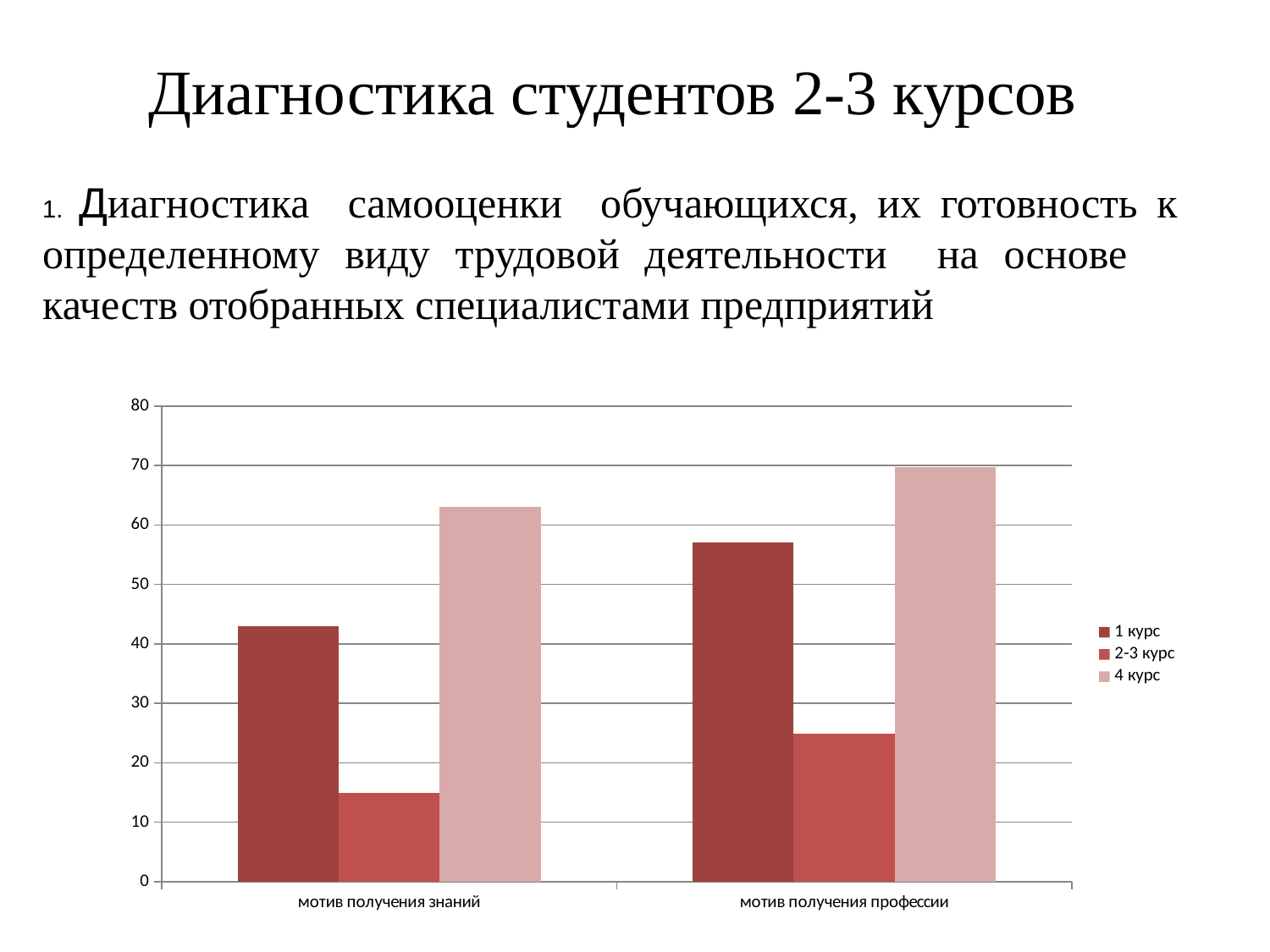
How many series does the legend list? 3 What are the three series listed in the legend? 1 курс, 2-3 курс, 4 курс Is the value for 2-3 курс in мотив получения знаний greater or less than 20? less Is the value for 4 курс in мотив получения знаний greater or less than 60? greater Which is larger for мотив получения знаний: 1 курс or 2-3 курс? 1 курс Is the value for 1 курс in мотив получения профессии greater or less than 50? greater Which is larger for 1 курс: мотив получения знаний or мотив получения профессии? мотив получения профессии Which series has the lowest value for мотив получения профессии? 2-3 курс What kind of chart is shown on the slide? bar chart Which series has the highest value for мотив получения знаний? 4 курс How many categories are shown on the x axis? 2